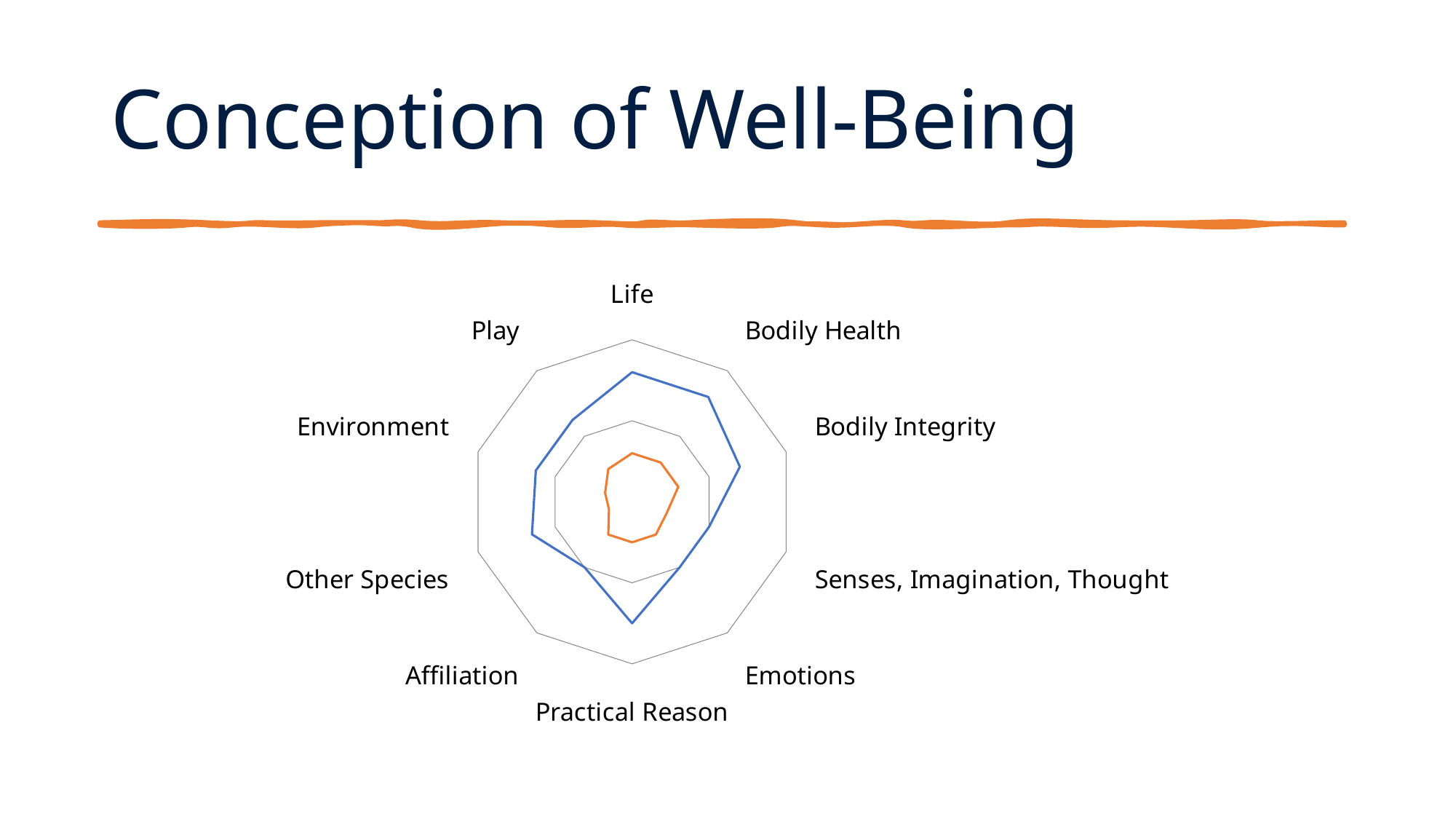
What is the title of the slide containing the radar chart? Conception of Well-Being For the orange series, which category has the lowest value? Other Species Which series has the larger value for Life, the blue one or the orange one? Blue Which series has the larger value for Practical Reason, the blue one or the orange one? Blue Which series has the larger value for Bodily Integrity, the blue one or the orange one? Blue How many data series are plotted on the radar chart? 2 How many categories (axes) does the radar chart have? 10 Which category label appears at the top of the radar chart? Life What kind of chart is shown on the slide? Radar chart